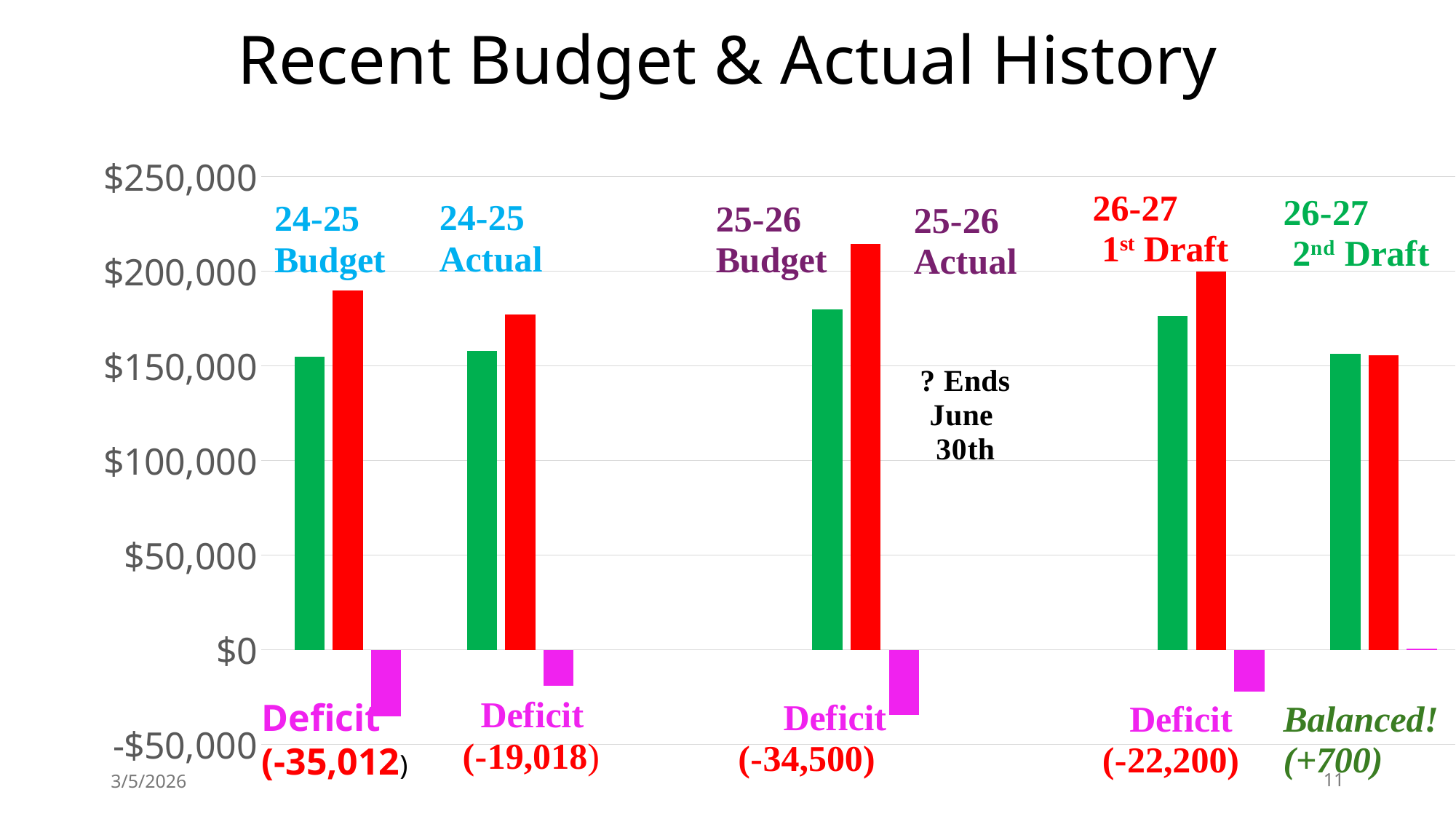
What deficit value is printed for the 25-26 Budget group? -34,500 Which group has the largest printed deficit? 24-25 Budget Which group has the tallest red bar? 25-26 Budget What value is printed for the 26-27 2nd Draft group? +700 Which group is labeled "Balanced!" on the slide? 26-27 2nd Draft What kind of chart is shown on the slide? bar chart Is the red bar for 25-26 Budget greater or less than $200,000? greater What is the difference between the printed deficits for 24-25 Budget (-35,012) and 24-25 Actual (-19,018)? 15,994 Is the red bar for 24-25 Budget greater or less than $200,000? less What deficit value is printed for the 24-25 Budget group? -35,012 What is the title of the chart on the slide? Recent Budget & Actual History What deficit value is printed for the 24-25 Actual group? -19,018